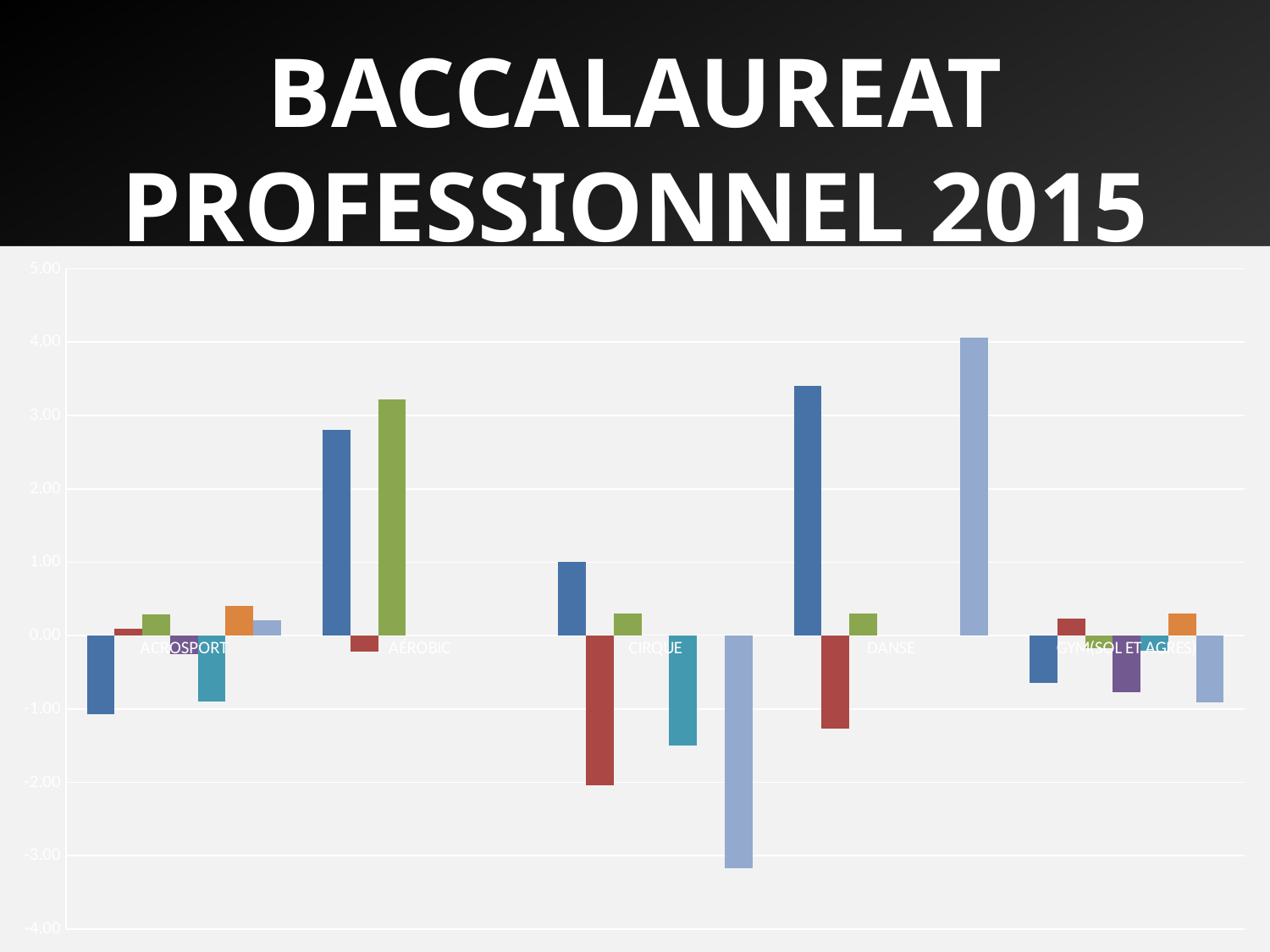
Is the value of the dark blue bar for DANSE greater or less than 3.00? greater Is the value of the teal bar for CIRQUE greater or less than -1.00? less What is the title shown above the chart? BACCALAUREAT PROFESSIONNEL 2015 Is the value of the green bar for AEROBIC greater or less than 3.00? greater Which is larger: the dark blue bar for AEROBIC or the dark blue bar for DANSE? DANSE Which is larger: the green bar for AEROBIC or the green bar for DANSE? AEROBIC Which category contains the lowest (most negative) bar on the chart? CIRQUE Which category contains the tallest bar on the chart? DANSE How many categories are shown on the x axis of the chart? 5 What kind of chart is shown on the slide? bar chart